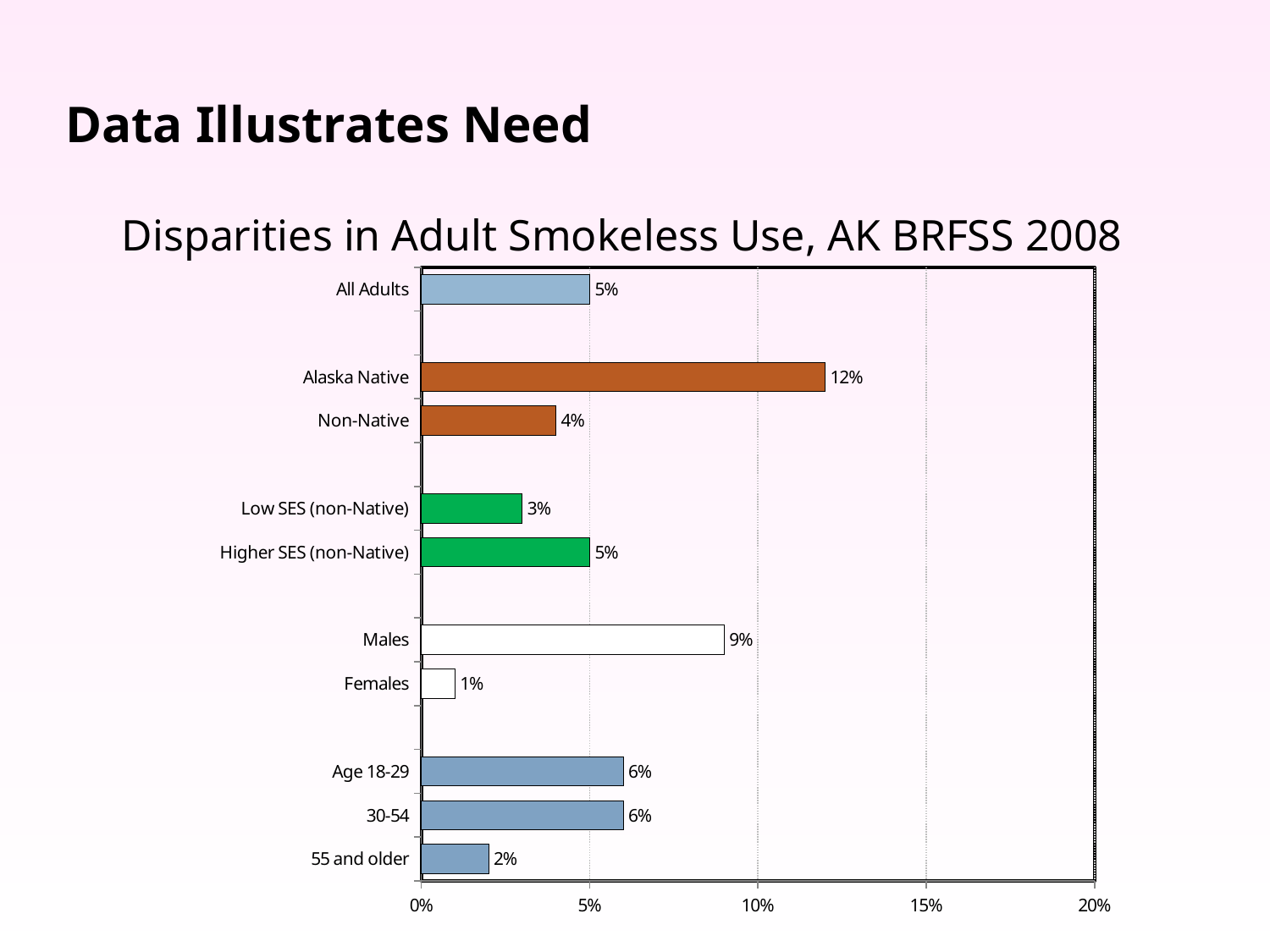
What is the difference between the values for Males and Females? 8% How many labelled categories are plotted in the chart? 10 What is the value for Females? 1% Which is larger, the value for Males or the value for All Adults? Males What is the value for Alaska Native? 12% Which category has the highest value? Alaska Native What is the value for 55 and older? 2% What kind of chart is shown on the slide? Bar chart What is the difference between the values for Alaska Native and Non-Native? 8% Is the value for Alaska Native greater or less than 10%? greater What is the value for Low SES (non-Native)? 3% Which category has the lowest value? Females